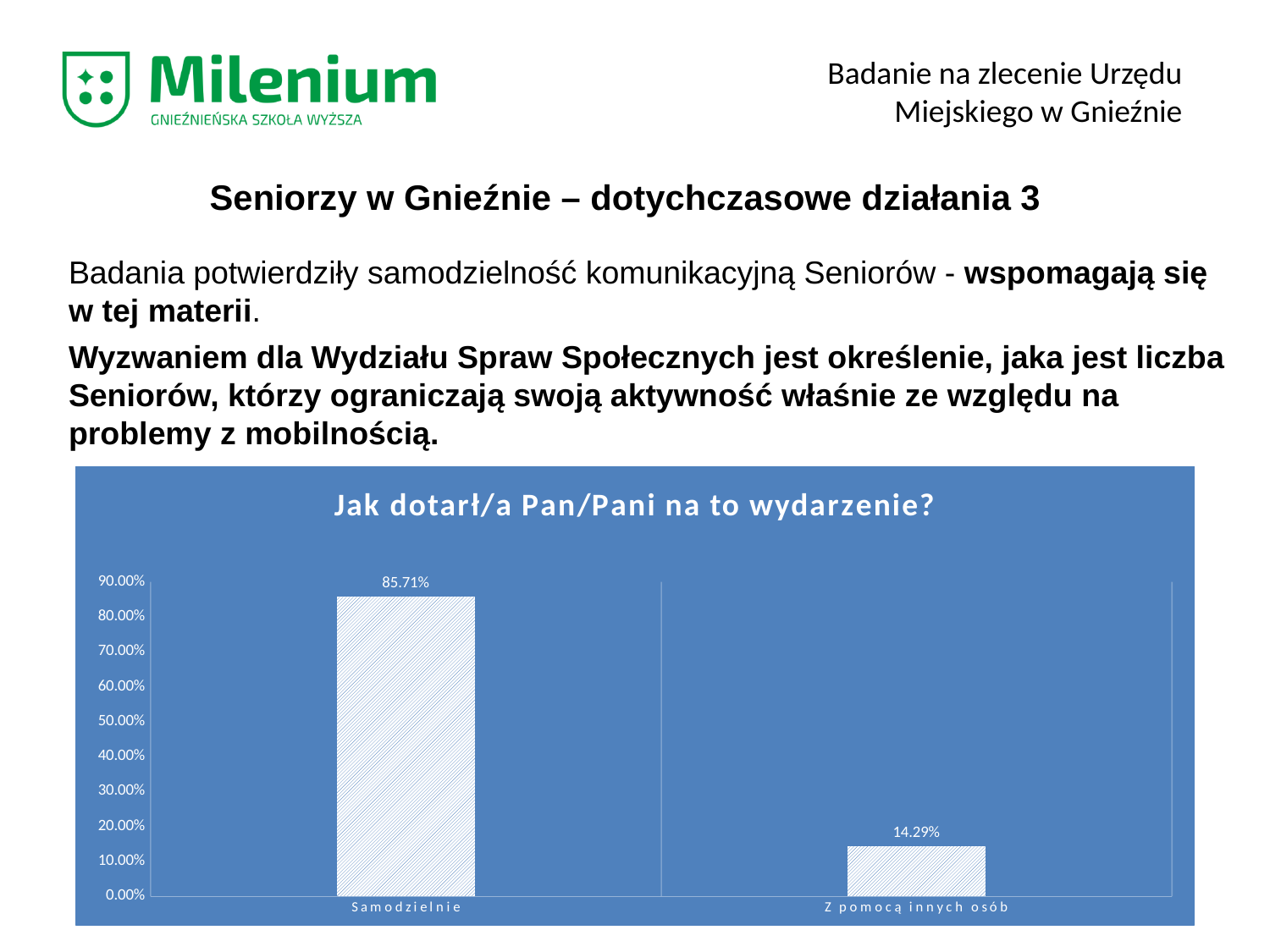
Which category has the highest value? Samodzielnie What is the title of the chart? Jak dotarł/a Pan/Pani na to wydarzenie? What kind of chart is shown on the slide? bar chart Which is larger, the value for "Samodzielnie" or for "Z pomocą innych osób"? Samodzielnie What is the value for "Samodzielnie"? 85.71% Which category has the lowest value? Z pomocą innych osób What is the highest value shown on the vertical axis of the chart? 90.00% Is the value for "Z pomocą innych osób" greater or less than 20.00%? less Is the value for "Samodzielnie" greater or less than 80.00%? greater What is the difference between the values for "Samodzielnie" and "Z pomocą innych osób"? 71.42% What is the value for "Z pomocą innych osób"? 14.29% How many categories are shown in the chart? 2